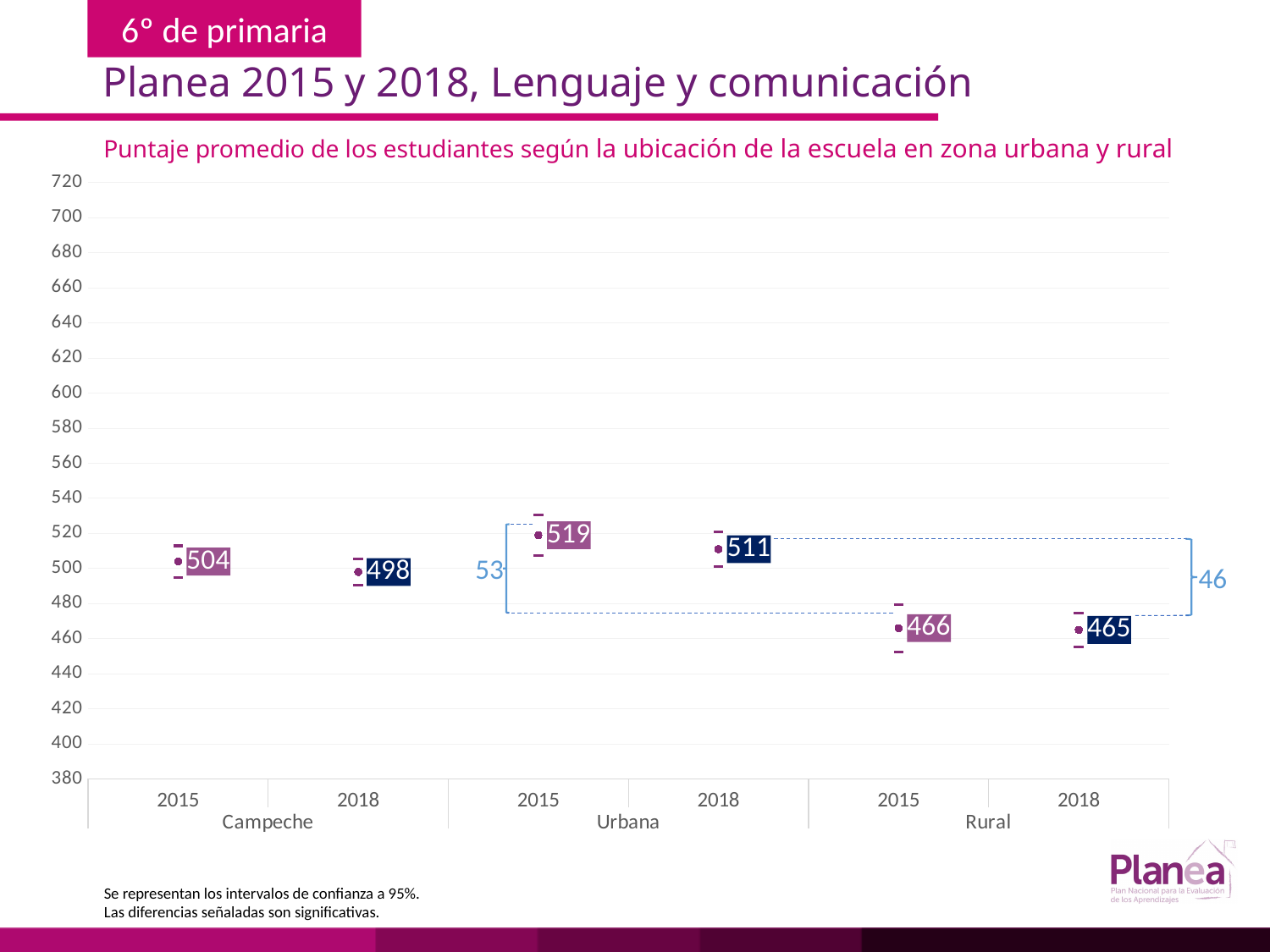
What is the title of the chart? Puntaje promedio de los estudiantes según la ubicación de la escuela en zona urbana y rural What is the average score for Rural schools in 2015? 466 Which group and year has the lowest average score? Rural 2018 (465) By how much did the Campeche score change from 2015 to 2018? 6 points lower (504 to 498) Is the Rural 2018 score greater or less than 480? less What is the average score for Urbana schools in 2018? 511 What is the difference between the Urbana and Rural scores in 2015? 53 How many data points are plotted on the chart? 6 Which is larger, the Campeche score in 2018 or the Urbana score in 2018? Urbana 2018 (511) Which group and year has the highest average score? Urbana 2015 (519) What is the average score for Campeche in 2015? 504 What is the difference between the Urbana and Rural scores in 2018? 46